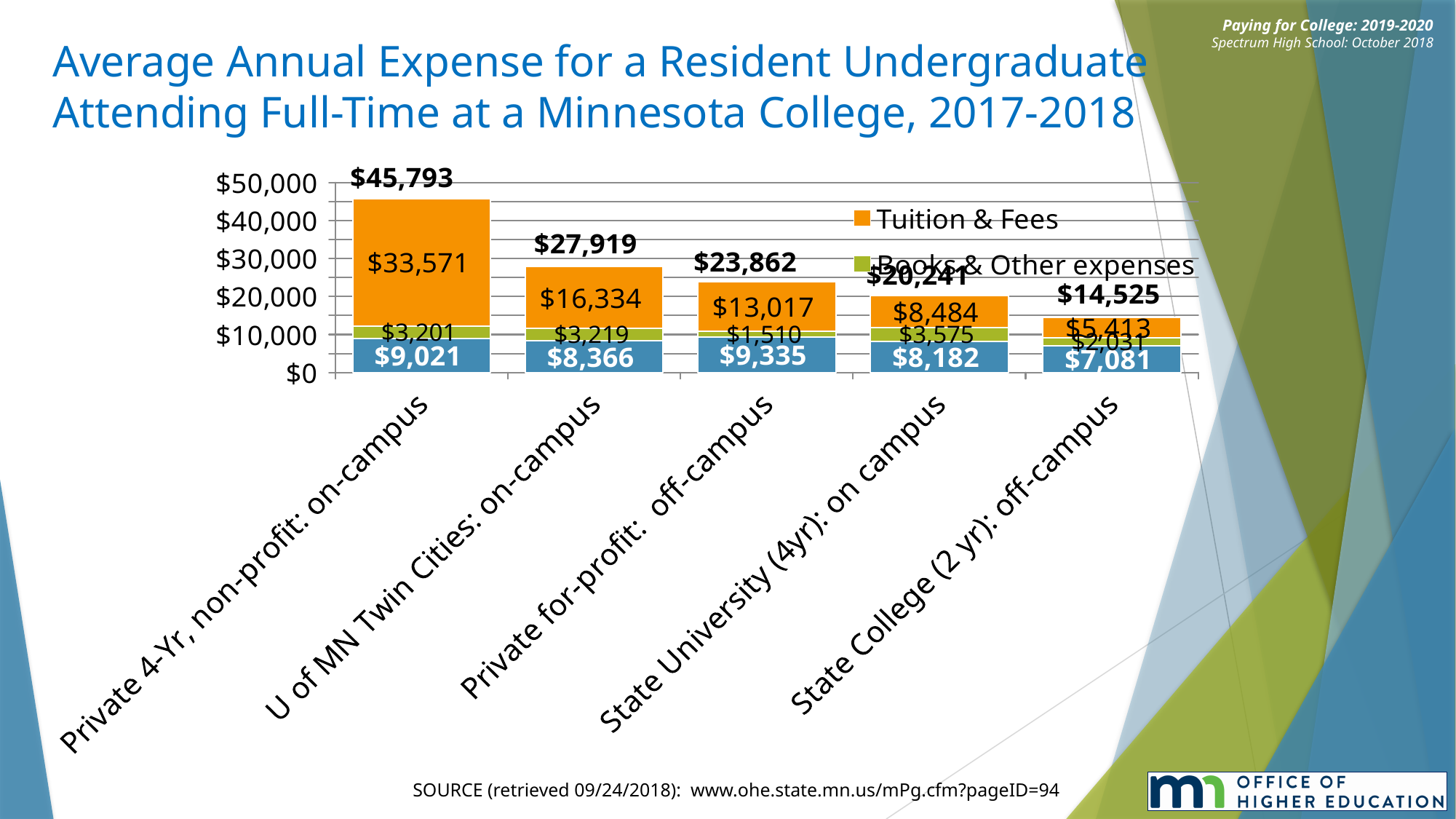
What is the difference between the total expense for Private 4-Yr, non-profit: on-campus and U of MN Twin Cities: on-campus? $17,874 Which is larger, the Tuition & Fees for Private for-profit: off-campus or for State University (4yr): on campus? Private for-profit: off-campus How many college types are shown on the x axis? 5 Which college type has the highest total average annual expense? Private 4-Yr, non-profit: on-campus What is the Books & Other expenses value for Private for-profit: off-campus? $1,510 What is the total average annual expense shown for State College (2 yr): off-campus? $14,525 Is the total expense for State University (4yr): on campus greater or less than $20,000? greater What is the Tuition & Fees value for Private 4-Yr, non-profit: on-campus? $33,571 Which college type has the lowest Tuition & Fees value? State College (2 yr): off-campus What is the difference in Tuition & Fees between U of MN Twin Cities: on-campus and Private for-profit: off-campus? $3,317 Do the total expenses rise or fall moving from left to right across the categories? Fall What kind of chart is shown on the slide? Stacked bar chart